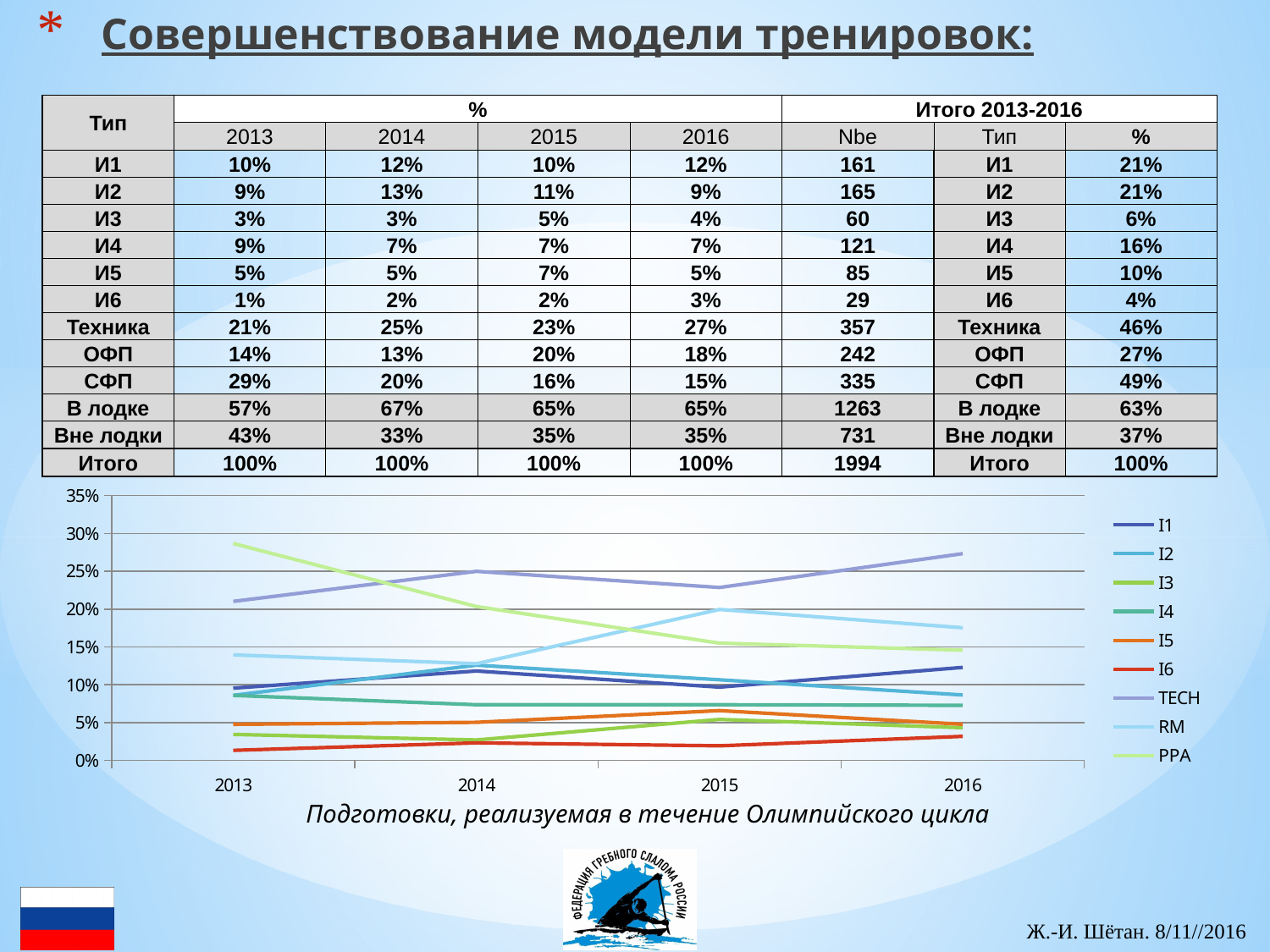
Is the value for TECH in 2016 greater or less than 25%? greater Which series has the highest value in 2013 on the chart? PPA Is the value for PPA in 2013 greater or less than 25%? greater How many years are plotted along the x axis of the chart? 4 Which series has the highest value in 2016 on the chart? TECH Which series has the lowest value in 2013 on the chart? I6 How many series does the chart's legend list? 9 In 2015, which is larger on the chart: RM or PPA? RM What are the first and last years shown on the chart's x axis? 2013 and 2016 Is the value for I6 in 2016 greater or less than 5%? less Does the PPA series rise or fall from 2013 to 2016? fall What kind of chart is shown below the table? line chart